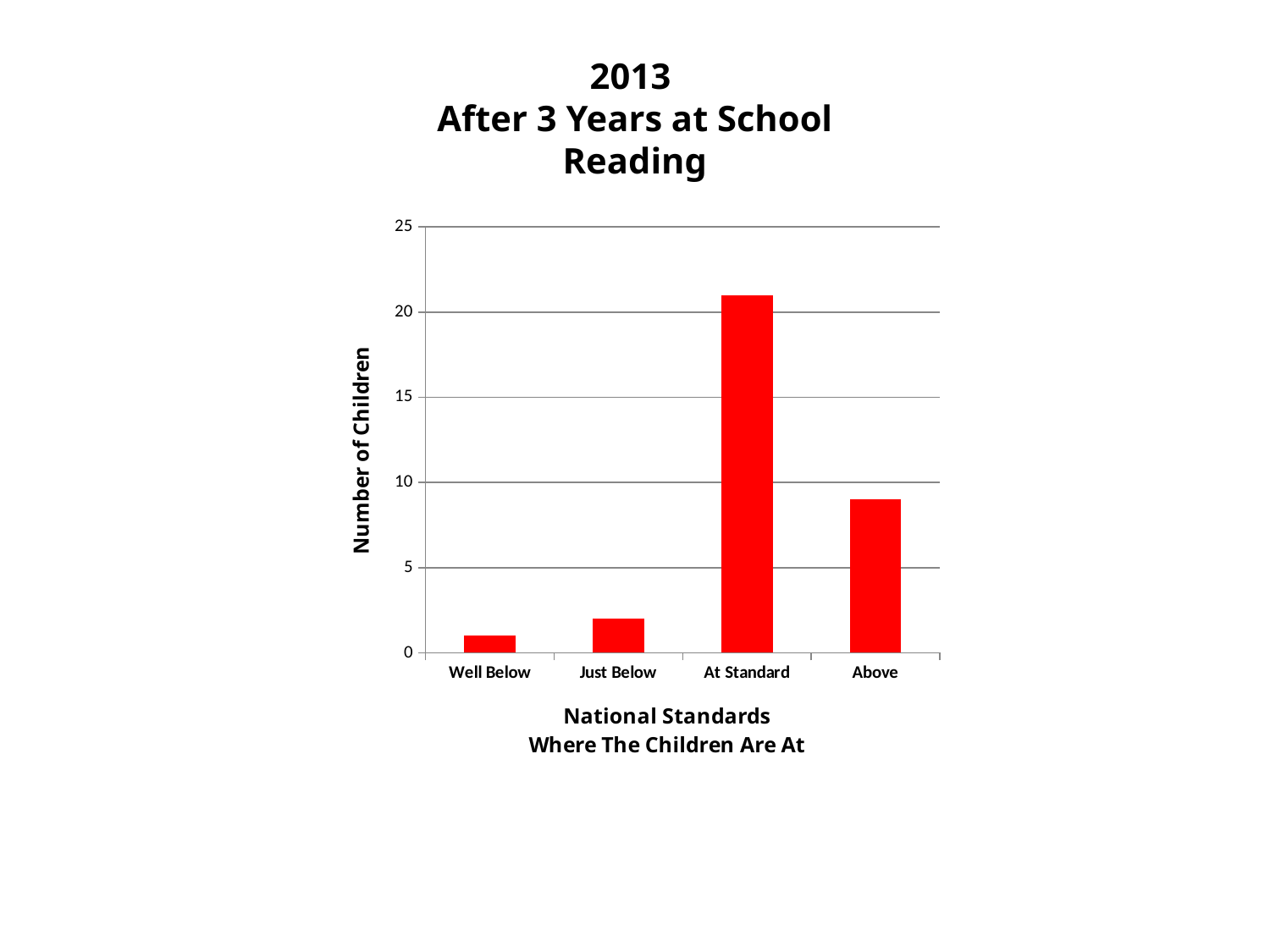
Which is larger, the value for Well Below or the value for At Standard? At Standard How many categories are shown on the x axis of the chart? 4 Is the value for Just Below greater or less than 5? less What is the title of the chart? 2013 After 3 Years at School Reading What kind of chart is shown on the slide? bar chart Is the value for Above greater or less than 10? less Is the value for Above greater or less than 5? greater Which category has the lowest number of children? Well Below Which category has the highest number of children? At Standard What is the label of the y axis? Number of Children Which is larger, the value for Above or the value for Just Below? Above